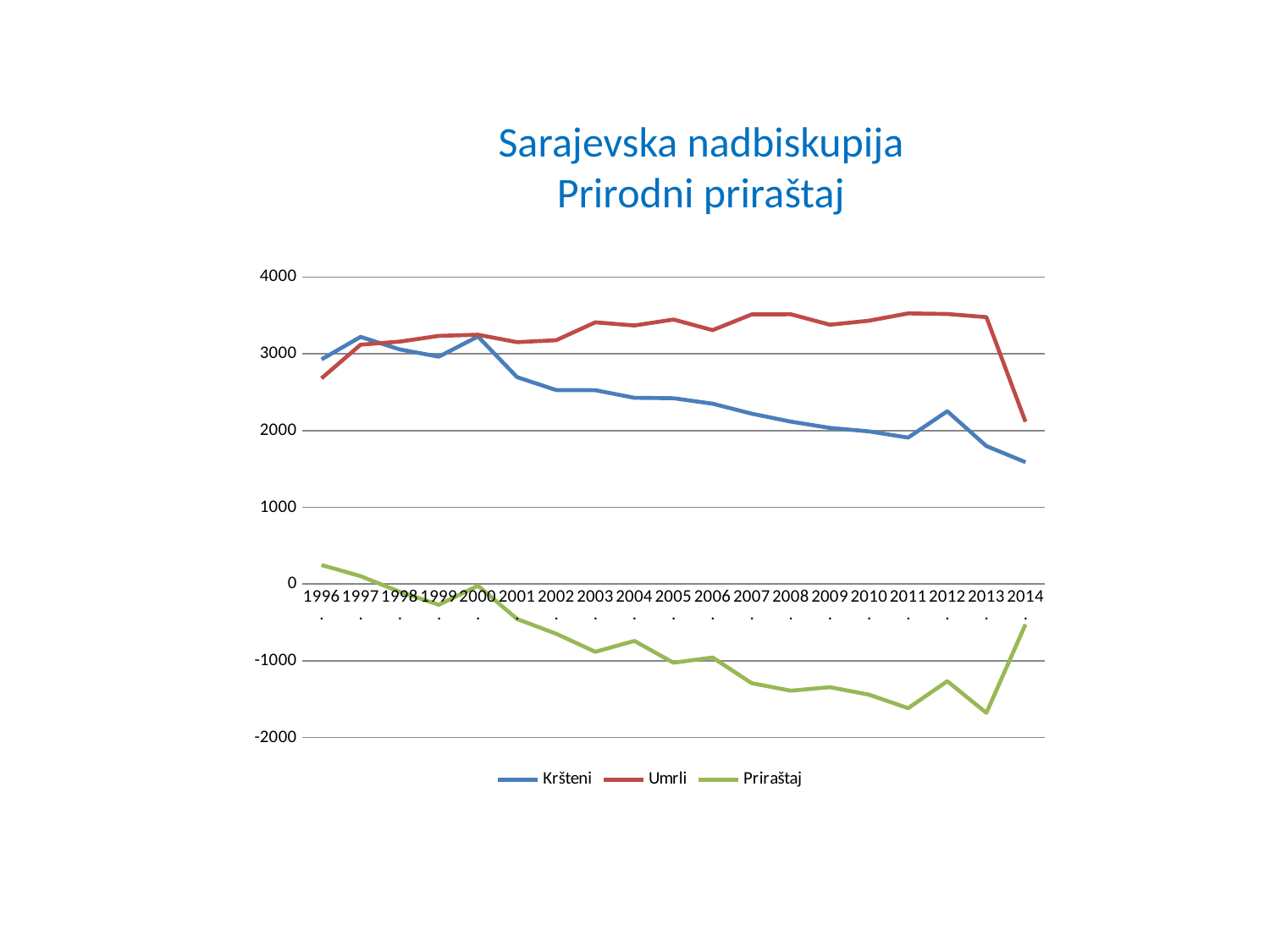
Which series is drawn in green? Priraštaj In which year is the Umrli series at its lowest? 2014 What kind of chart is shown on the slide? line chart In 2010, which series has the larger value, Kršteni or Umrli? Umrli What is the title of the chart? Sarajevska nadbiskupija Prirodni priraštaj Is the value for Umrli in 2007 greater or less than 3000? greater Does the Kršteni series generally rise or fall from 1996 to 2014? fall Is the value for Priraštaj in 1996 greater or less than 0? greater Is the value for Priraštaj in 2013 greater or less than -1000? less How many series does the legend list? 3 How many years are plotted along the x axis? 19